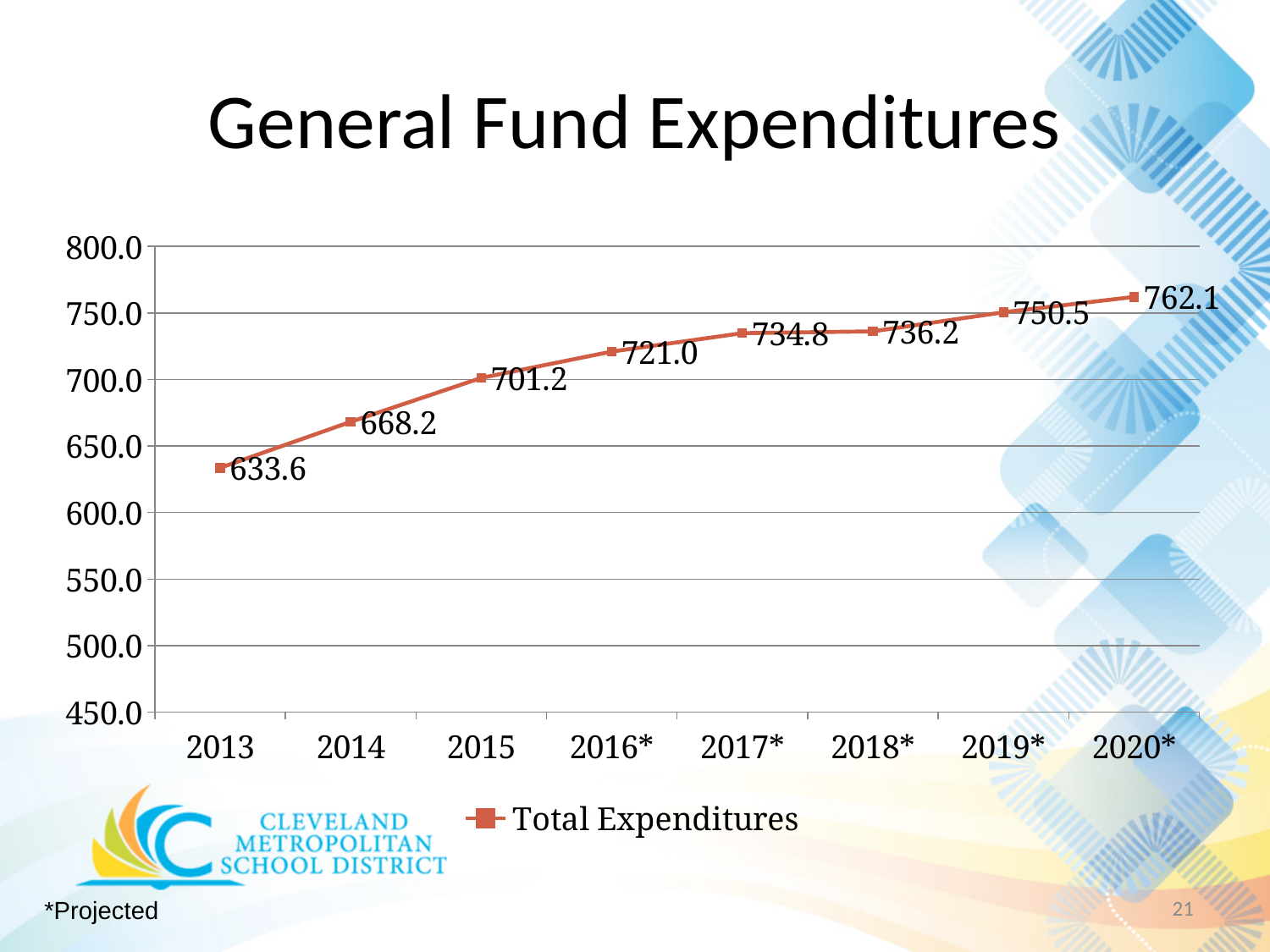
What is the value of Total Expenditures for 2017*? 734.8 Do Total Expenditures rise or fall from 2013 to 2020*? rise What kind of chart is shown on the slide? line chart What is the difference between Total Expenditures in 2015 and 2014? 33.0 Is the value for 2015 greater or less than 700.0? greater What is the difference between Total Expenditures in 2020* and 2013? 128.5 Which year has the lowest Total Expenditures? 2013 What is the value of Total Expenditures for 2013? 633.6 Which year has the highest Total Expenditures? 2020* What is the value of Total Expenditures for 2020*? 762.1 Which is larger, Total Expenditures in 2016* or in 2019*? 2019* How many years are shown on the x axis? 8